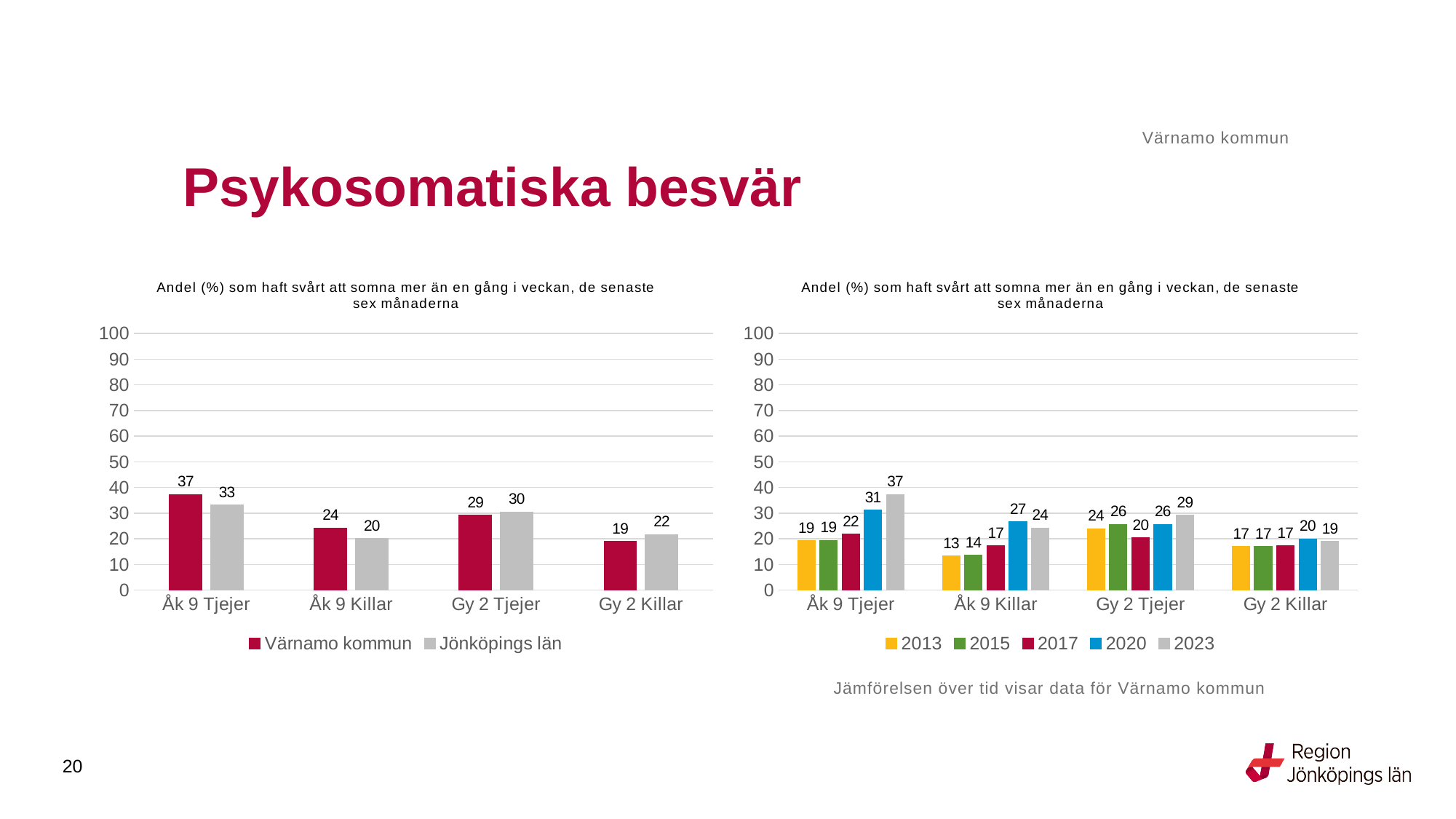
In the left chart, which is larger for Gy 2 Tjejer: Värnamo kommun or Jönköpings län? Jönköpings län In the right chart, how many series does the legend list? 5 In the left chart, what is the value for Jönköpings län for Gy 2 Killar? 22 In the right chart, what is the value for 2020 for Åk 9 Killar? 27 In the right chart, which year has the highest value for Åk 9 Tjejer? 2023 In the right chart, what is the difference between the 2023 and 2013 values for Åk 9 Tjejer? 18 In the right chart, what is the value for 2013 for Gy 2 Tjejer? 24 What kind of chart is the right chart? Bar chart In the left chart, what is the difference between Värnamo kommun and Jönköpings län for Åk 9 Killar? 4 In the left chart, what is the value for Värnamo kommun for Åk 9 Tjejer? 37 In the left chart, which category has the lowest value for Värnamo kommun? Gy 2 Killar In the left chart, how many series does the legend list? 2